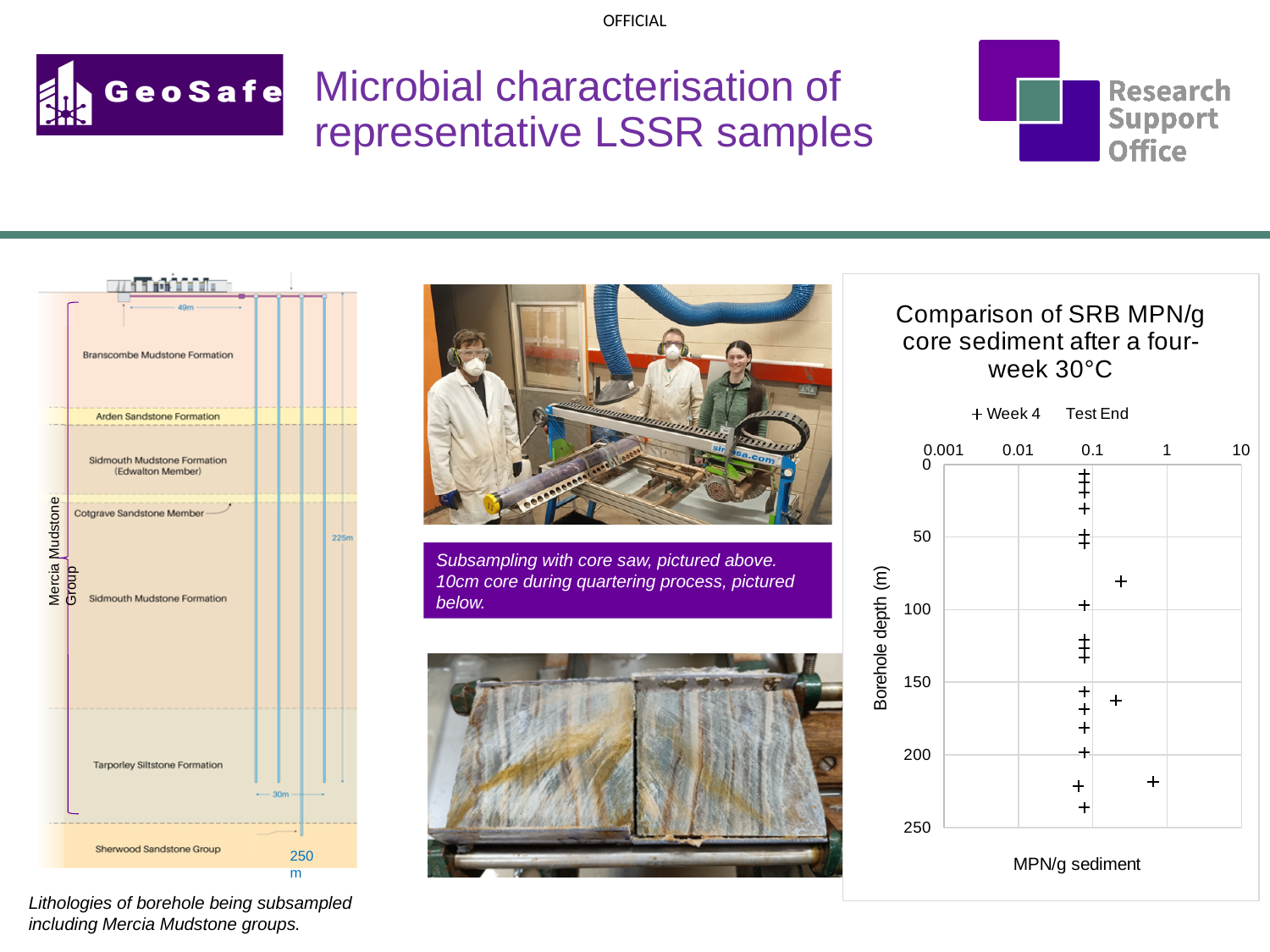
What is the maximum borehole depth shown on the vertical axis of the chart? 250 What is the maximum value shown on the horizontal axis of the chart? 10 In the chart, are all plotted values less than 10 MPN/g sediment? Yes What kind of chart is shown on the right of the slide? Scatter plot How many series does the legend of the chart list? 2 What is the title of the chart on the right of the slide? Comparison of SRB MPN/g core sediment after a four-week 30°C What is the label of the vertical axis of the chart? Borehole depth (m)